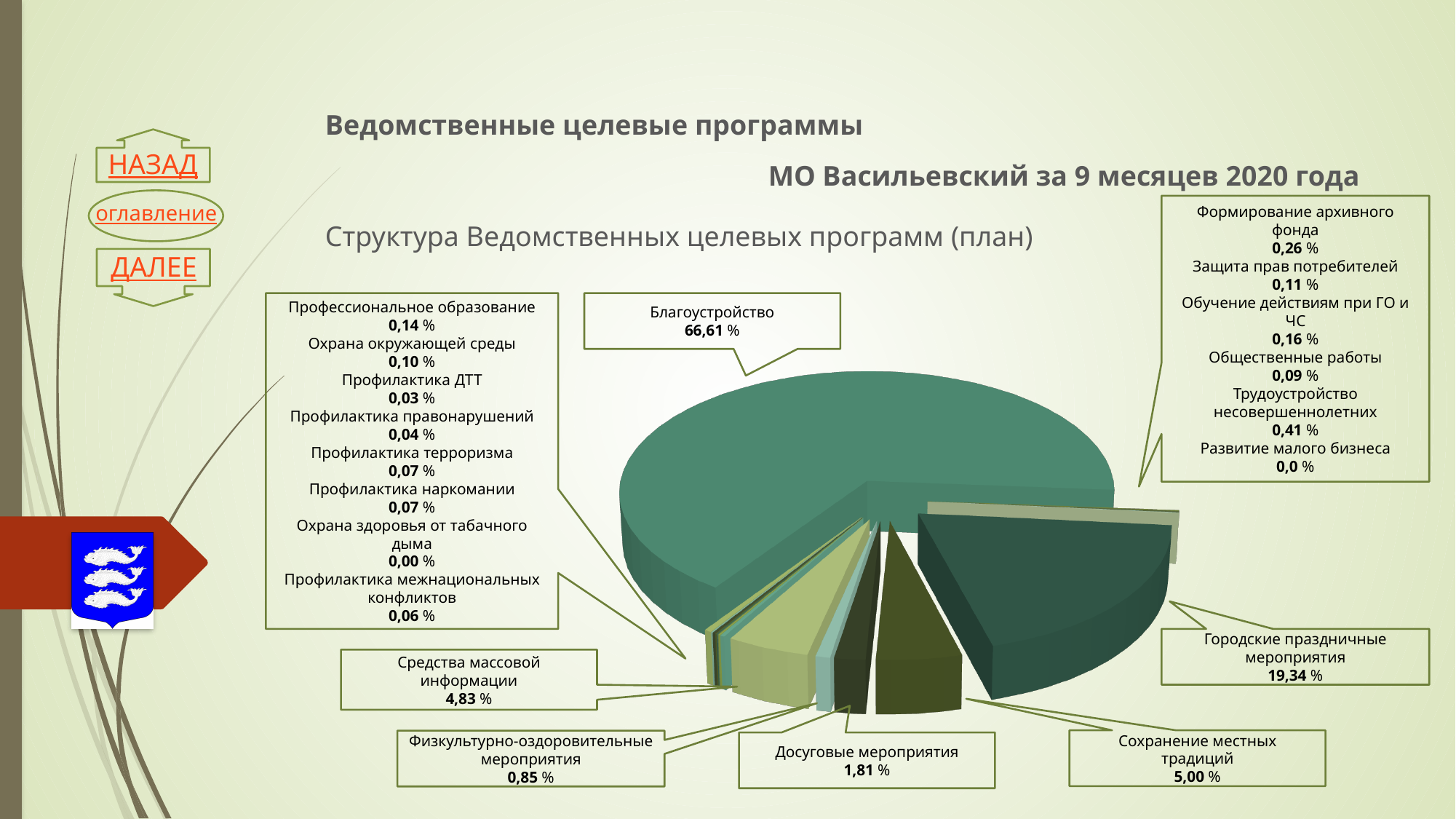
Which is larger: Сохранение местных традиций or Средства массовой информации? Сохранение местных традиций What kind of chart is shown on the slide? pie chart What is the title of the chart? Структура Ведомственных целевых программ (план) What share does Благоустройство have in the pie chart? 66,61 % What is the value for Средства массовой информации? 4,83 % Which category has the largest share of the pie? Благоустройство What is the difference between the shares of Благоустройство and Городские праздничные мероприятия? 47,27 % What is the value for Профессиональное образование? 0,14 % How many categories are labelled in the pie chart? 20 What is the value for Трудоустройство несовершеннолетних? 0,41 % What is the difference between the shares of Досуговые мероприятия and Физкультурно-оздоровительные мероприятия? 0,96 % What is the value for Городские праздничные мероприятия? 19,34 %